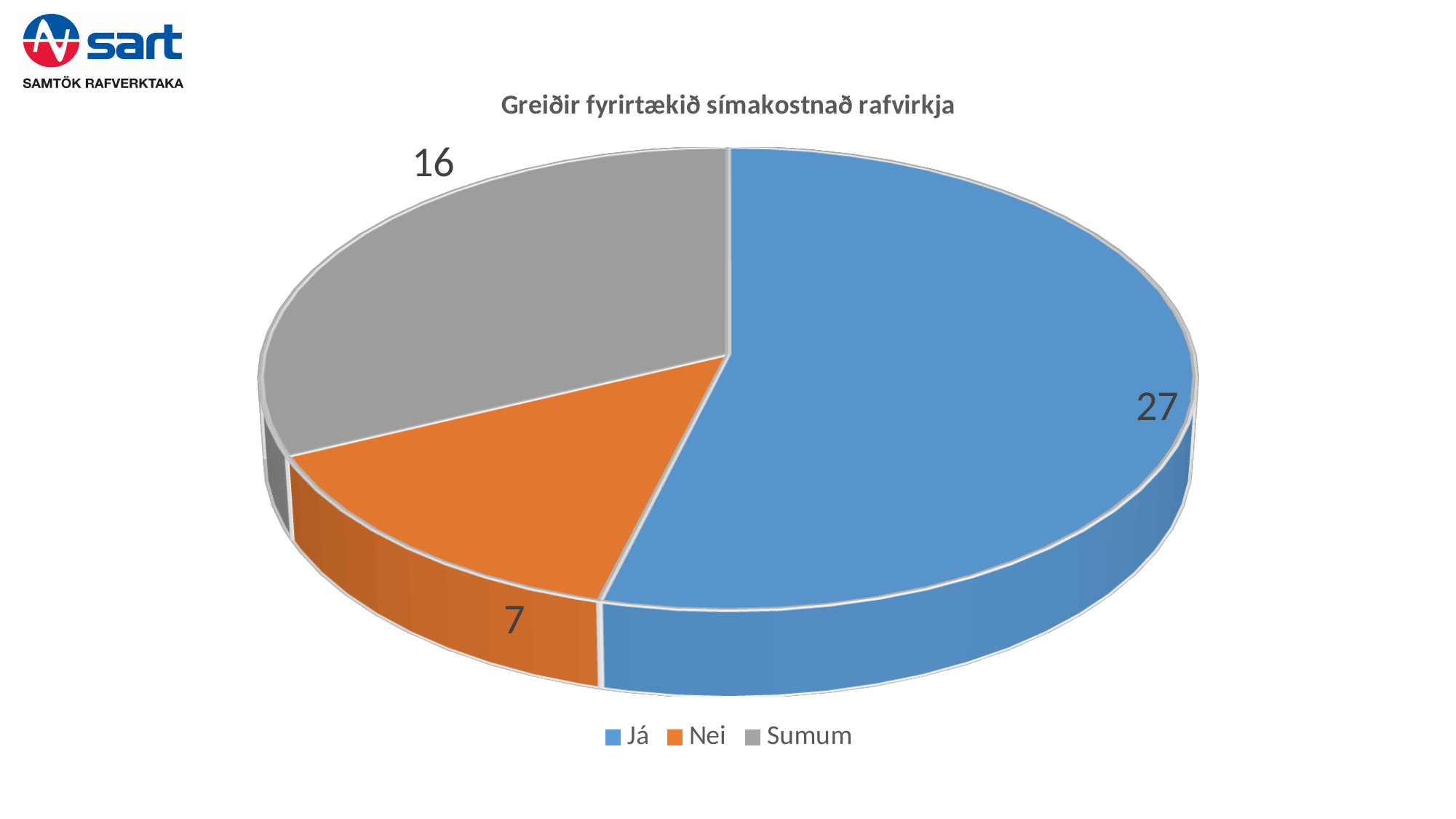
What is the value for Já? 27 How many categories does the pie chart show? 3 Which is larger, the value for Sumum or the value for Nei? Sumum Which category has the largest slice? Já What is the value for Sumum? 16 What kind of chart is shown on the slide? Pie chart What is the title of the chart? Greiðir fyrirtækið símakostnað rafvirkja Which category has the smallest slice? Nei What is the difference between the values for Sumum and Nei? 9 What is the value for Nei? 7 What is the difference between the values for Já and Sumum? 11 What share of the pie does the Já slice represent? 54%